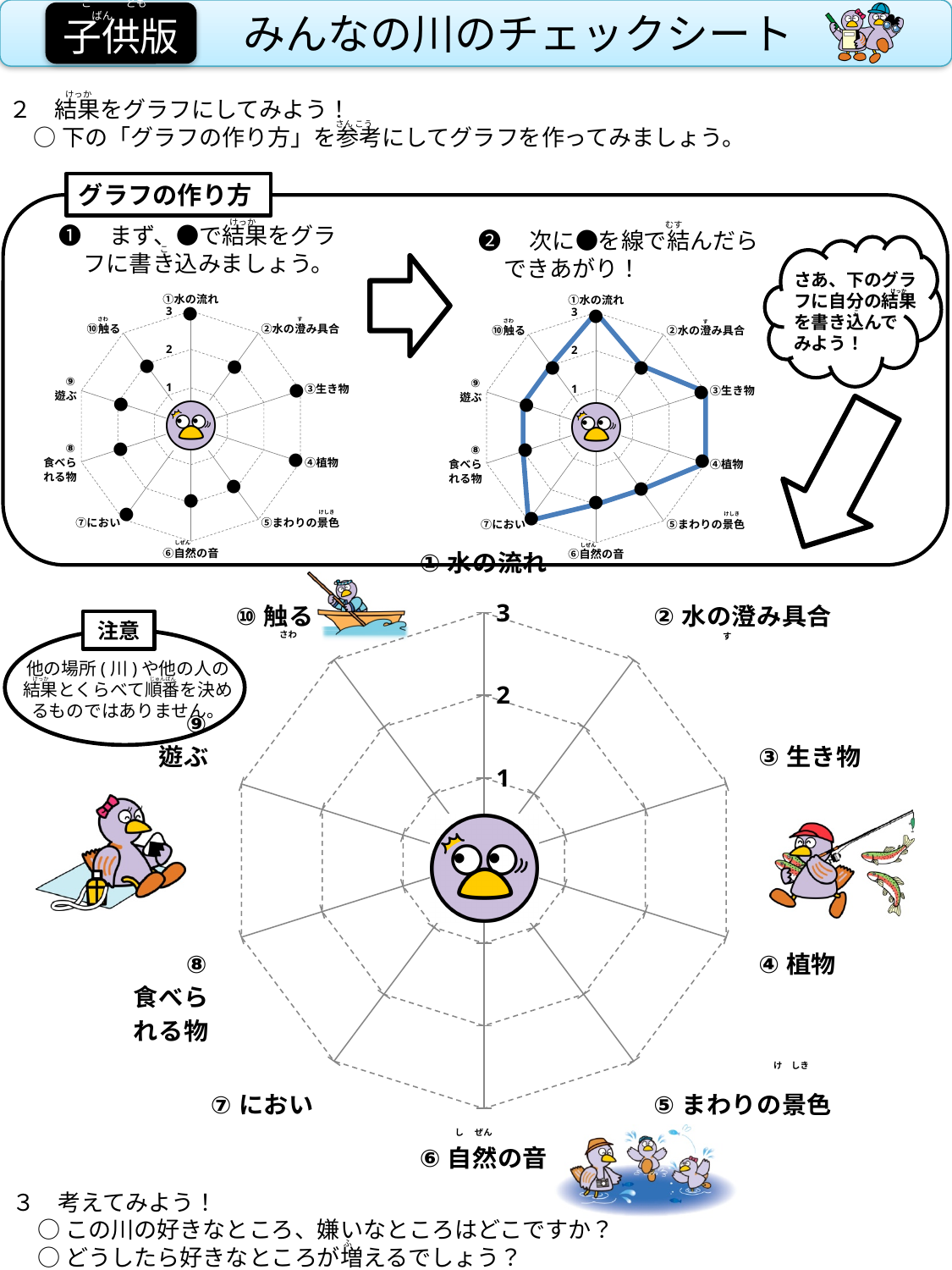
In the completed example chart in the 'グラフの作り方' box, what value is plotted for ①水の流れ? 3 In the completed example chart in the 'グラフの作り方' box, what value is plotted for ⑦におい? 3 What is the highest value shown on the axis of the large radar chart? 3 How many categories are plotted on the example radar charts in the 'グラフの作り方' box? 10 In the completed example chart in the 'グラフの作り方' box, what is the difference between the value for ④植物 and the value for ⑩触る? 1 In the completed example chart in the 'グラフの作り方' box, what value is plotted for ⑥自然の音? 2 In the completed example chart in the 'グラフの作り方' box, which is larger, the value for ③生き物 or the value for ⑤まわりの景色? ③生き物 What kind of chart is the large chart in the middle of the slide? radar chart In the completed example chart in the 'グラフの作り方' box, what value is plotted for ②水の澄み具合? 2 What is the label of category ① on the large radar chart? 水の流れ How many categories (axes) does the large radar chart have? 10